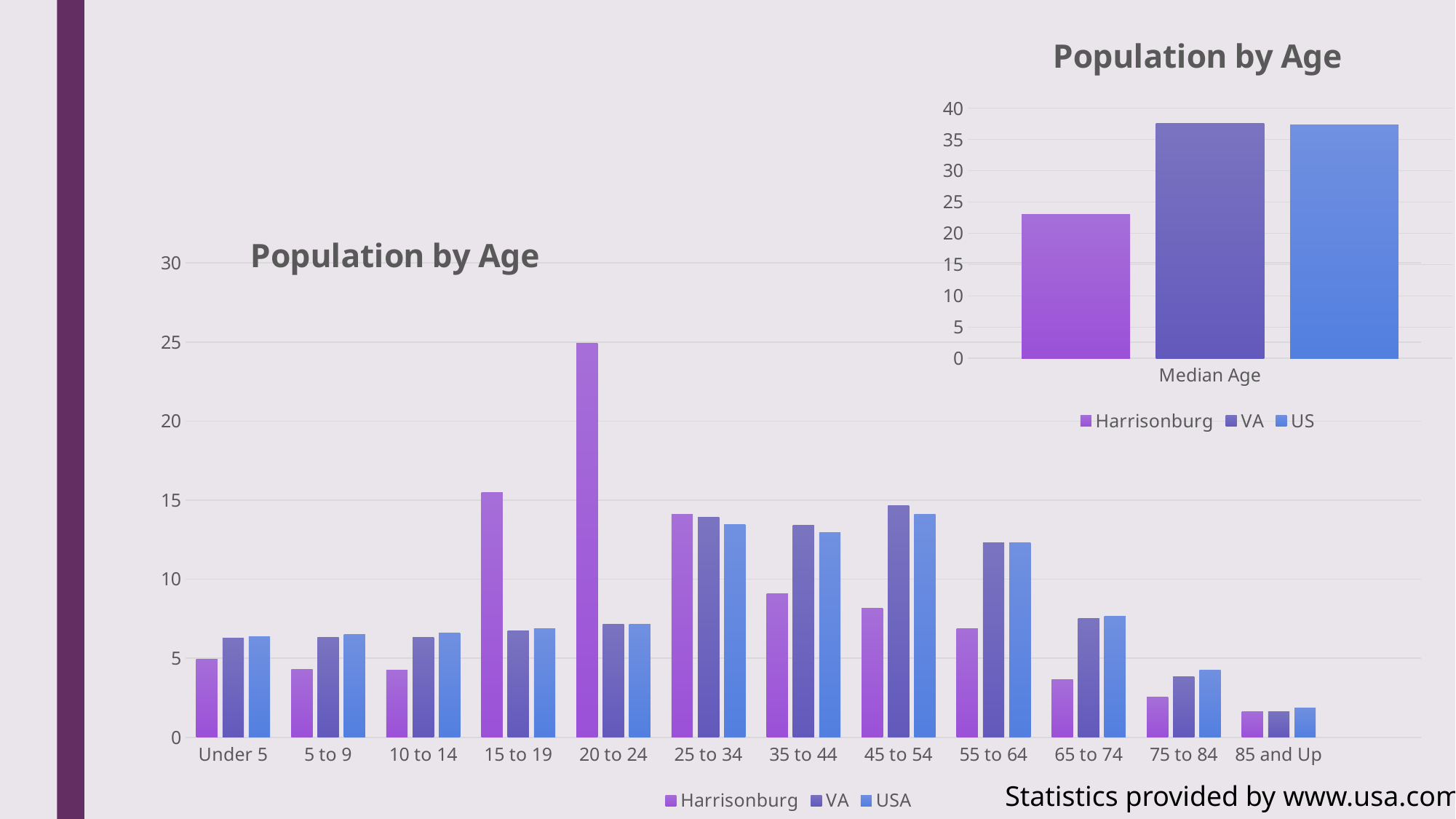
In the small chart at the top right, is the Harrisonburg Median Age greater or less than 25? less In the large chart on the left, for the 45 to 54 category, which is larger: the Harrisonburg value or the VA value? VA In the large chart on the left, how many age categories are shown on the x axis? 12 In the large chart on the left, which age category has the lowest Harrisonburg value? 85 and Up In the large chart on the left, is the Harrisonburg value for 5 to 9 greater or less than 5? less In the large chart on the left, is the VA value for 55 to 64 greater or less than 10? greater In the small chart at the top right, what is the label of the category on the x axis? Median Age What kind of chart is the large chart on the left of the slide? bar chart In the large chart on the left, how many series does the legend list? 3 In the small chart at the top right, which series has the lowest Median Age? Harrisonburg In the large chart on the left, which age category has the highest Harrisonburg value? 20 to 24